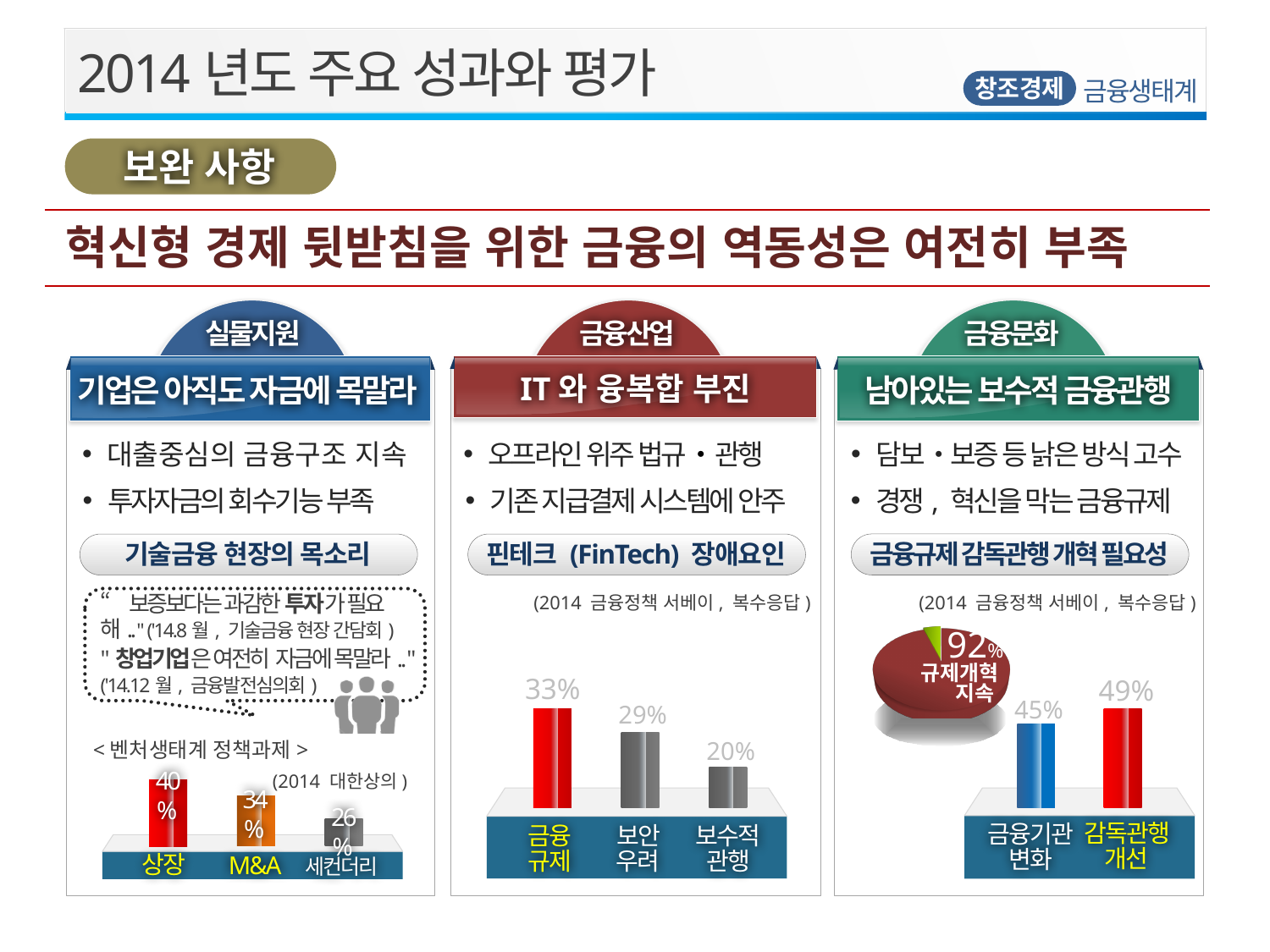
In the '핀테크 (FinTech) 장애요인' chart, which category has the lowest value? 보수적 관행 What kind of chart is the '핀테크 (FinTech) 장애요인' chart? bar chart In the '핀테크 (FinTech) 장애요인' chart, what is the value for 금융규제? 33% In the '벤처생태계 정책과제' chart, do the values rise or fall from left to right? fall In the '벤처생태계 정책과제' chart, what is the value for M&A? 34% In the '벤처생태계 정책과제' chart, what is the difference between 상장 and 세컨더리? 14% In the '금융규제 감독관행 개혁 필요성' pie chart, what share is labelled 규제개혁 지속? 92% In the '핀테크 (FinTech) 장애요인' chart, what is the difference between 금융규제 and 보안우려? 4% In the '벤처생태계 정책과제' chart, which category has the highest value? 상장 In the '금융규제 감독관행 개혁 필요성' bar chart, which is larger, 금융기관 변화 or 감독관행 개선? 감독관행 개선 In the '핀테크 (FinTech) 장애요인' chart, how many categories are shown? 3 In the '금융규제 감독관행 개혁 필요성' bar chart, what is the value for 감독관행 개선? 49%